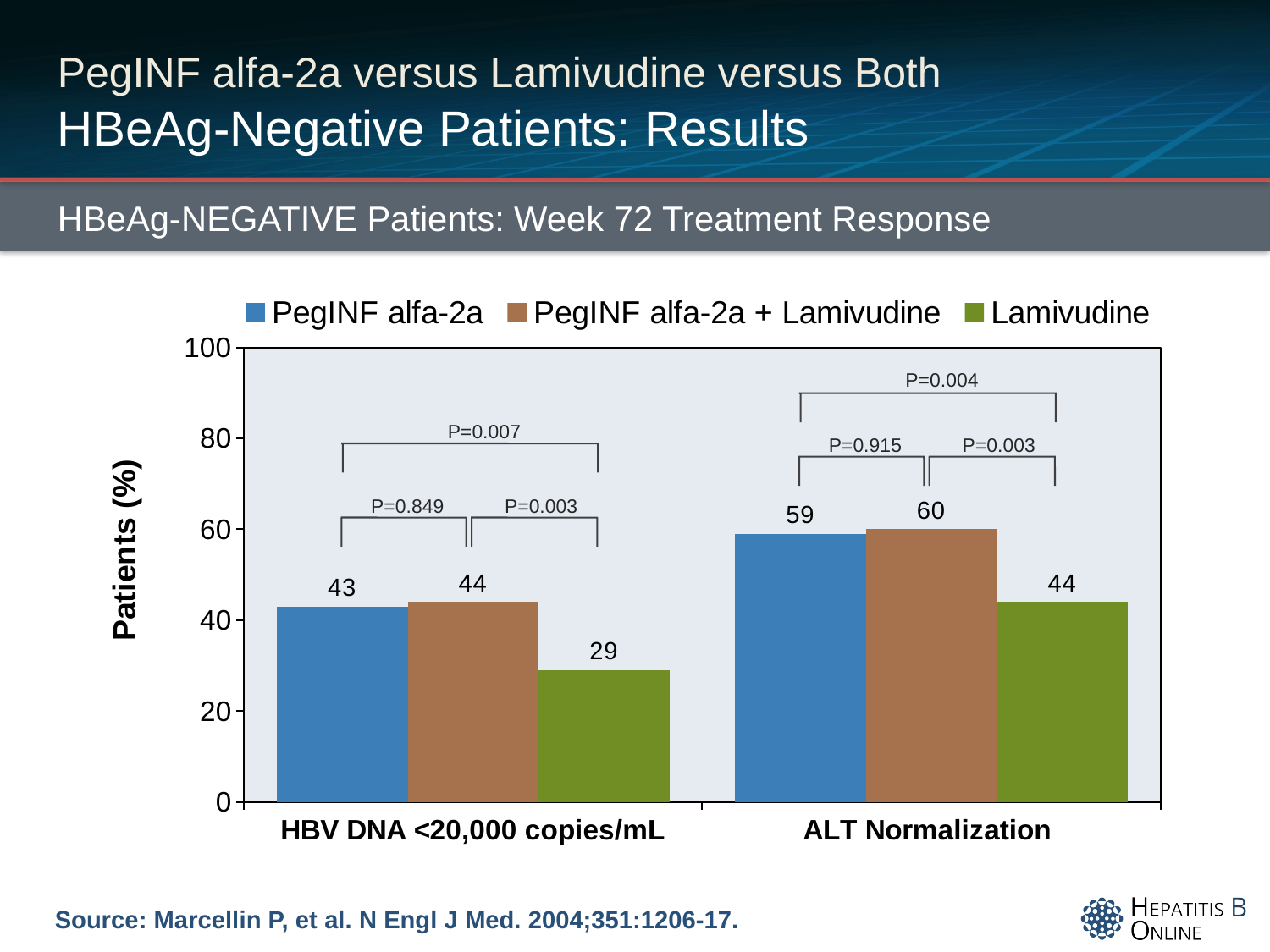
Which is larger: the Lamivudine value for ALT Normalization or the Lamivudine value for HBV DNA <20,000 copies/mL? ALT Normalization What is the difference between the PegINF alfa-2a value for ALT Normalization and its value for HBV DNA <20,000 copies/mL? 16 What is the difference between the PegINF alfa-2a + Lamivudine and Lamivudine values for HBV DNA <20,000 copies/mL? 15 How many series does the legend list? 3 Is the value for PegINF alfa-2a in the ALT Normalization category greater or less than 40? greater What type of chart is shown on the slide? Bar chart How many categories are shown on the x axis? 2 What percentage of patients in the Lamivudine group achieved ALT Normalization? 44 Which treatment group has the highest value for ALT Normalization? PegINF alfa-2a + Lamivudine What percentage of patients in the PegINF alfa-2a group achieved HBV DNA <20,000 copies/mL? 43 What is the value for PegINF alfa-2a + Lamivudine in the ALT Normalization category? 60 Which treatment group has the lowest value for HBV DNA <20,000 copies/mL? Lamivudine